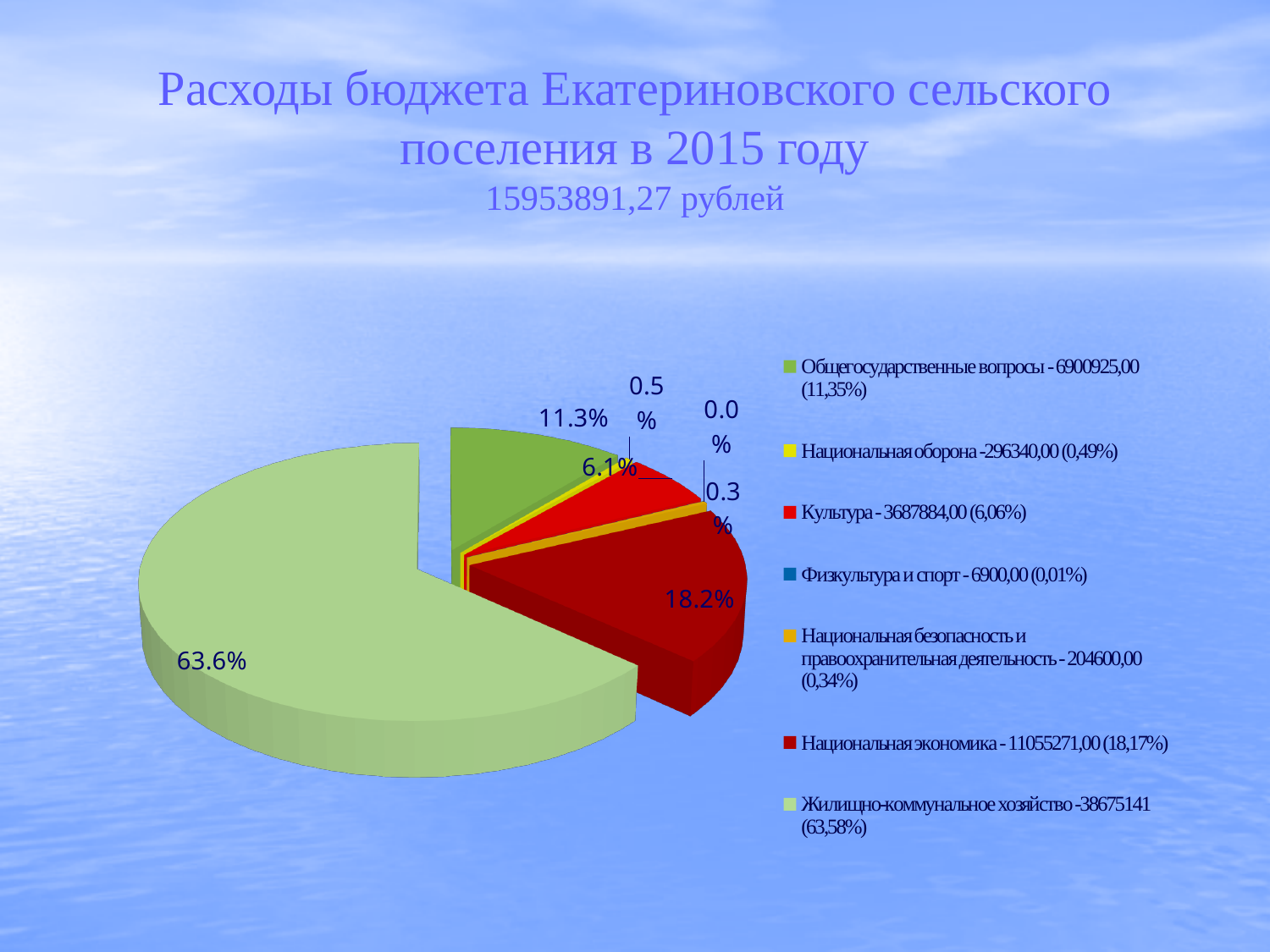
Which category has the smallest slice of the pie? Физкультура и спорт What total amount in rubles is stated in the slide title? 15953891,27 рублей What kind of chart is shown on the slide? pie chart What share of the pie does Жилищно-коммунальное хозяйство have according to its data label? 63.6% What share of the pie does Культура have according to its data label? 6.1% What amount in rubles does the legend give for Национальная оборона? 296340,00 What is the difference in percentage points between the data labels for Жилищно-коммунальное хозяйство (63.6%) and Национальная экономика (18.2%)? 45.4 How many categories does the legend of the pie chart list? 7 Which slice is larger: Национальная экономика or Общегосударственные вопросы? Национальная экономика Which category has the largest slice of the pie? Жилищно-коммунальное хозяйство What share of the pie does Общегосударственные вопросы have according to its data label? 11.3%